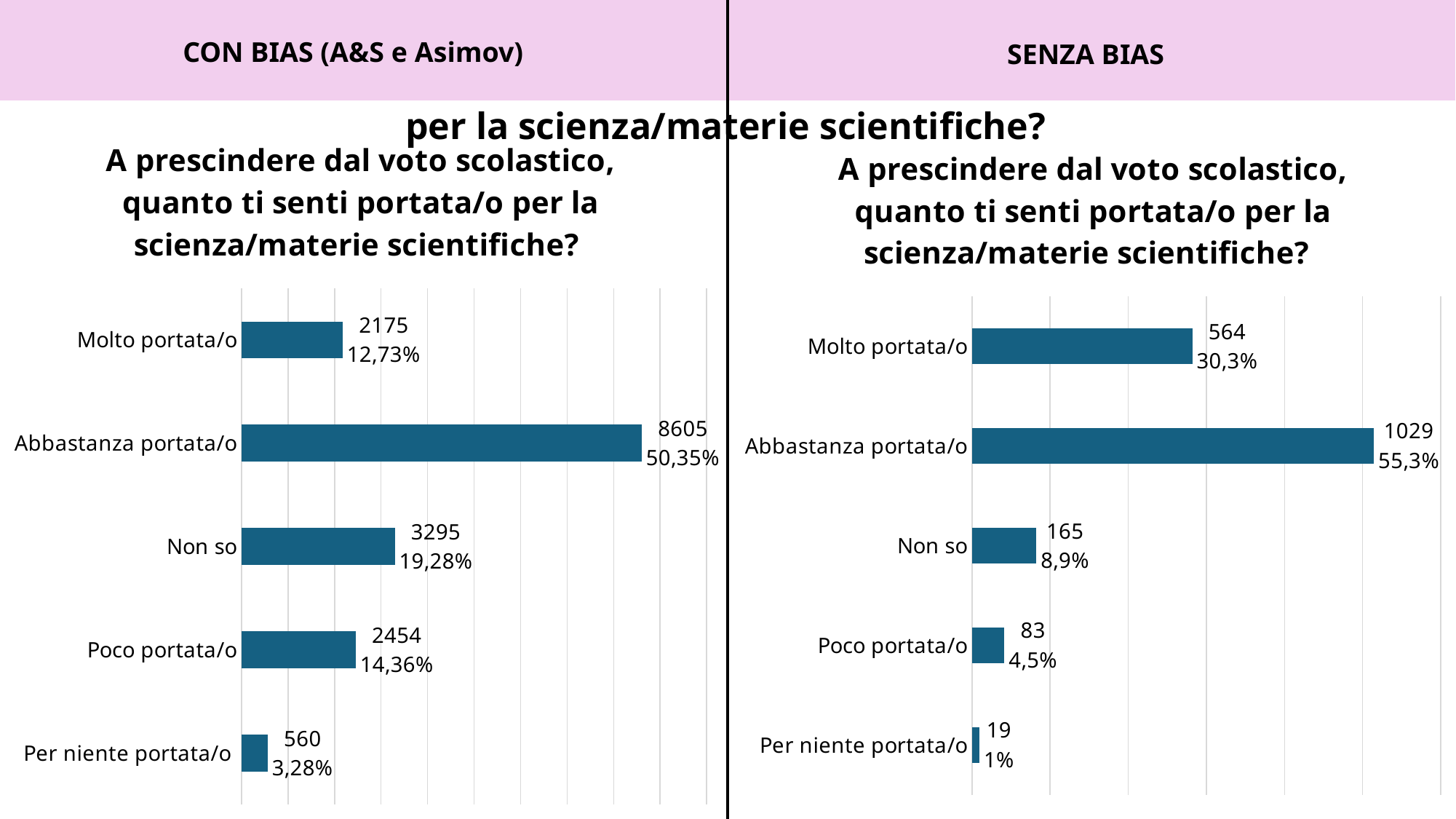
In the CON BIAS chart on the left, which category has the lowest value? Per niente portata/o In the SENZA BIAS chart on the right, what percentage is shown for Molto portata/o? 30,3% In the SENZA BIAS chart on the right, which category has the highest value? Abbastanza portata/o What type of chart is the SENZA BIAS chart on the right? Bar chart In the SENZA BIAS chart on the right, what is the count for Per niente portata/o? 19 How many categories does the CON BIAS chart on the left show? 5 In the CON BIAS chart on the left, what is the count for Abbastanza portata/o? 8605 In the SENZA BIAS chart on the right, what is the difference between the counts for Abbastanza portata/o and Molto portata/o? 465 In the SENZA BIAS chart on the right, which is larger: the count for Non so or the count for Poco portata/o? Non so In the CON BIAS chart on the left, what is the difference between the counts for Non so and Poco portata/o? 841 What is the heading above the chart on the left side of the slide? CON BIAS (A&S e Asimov) In the CON BIAS chart on the left, what percentage is shown for Non so? 19,28%